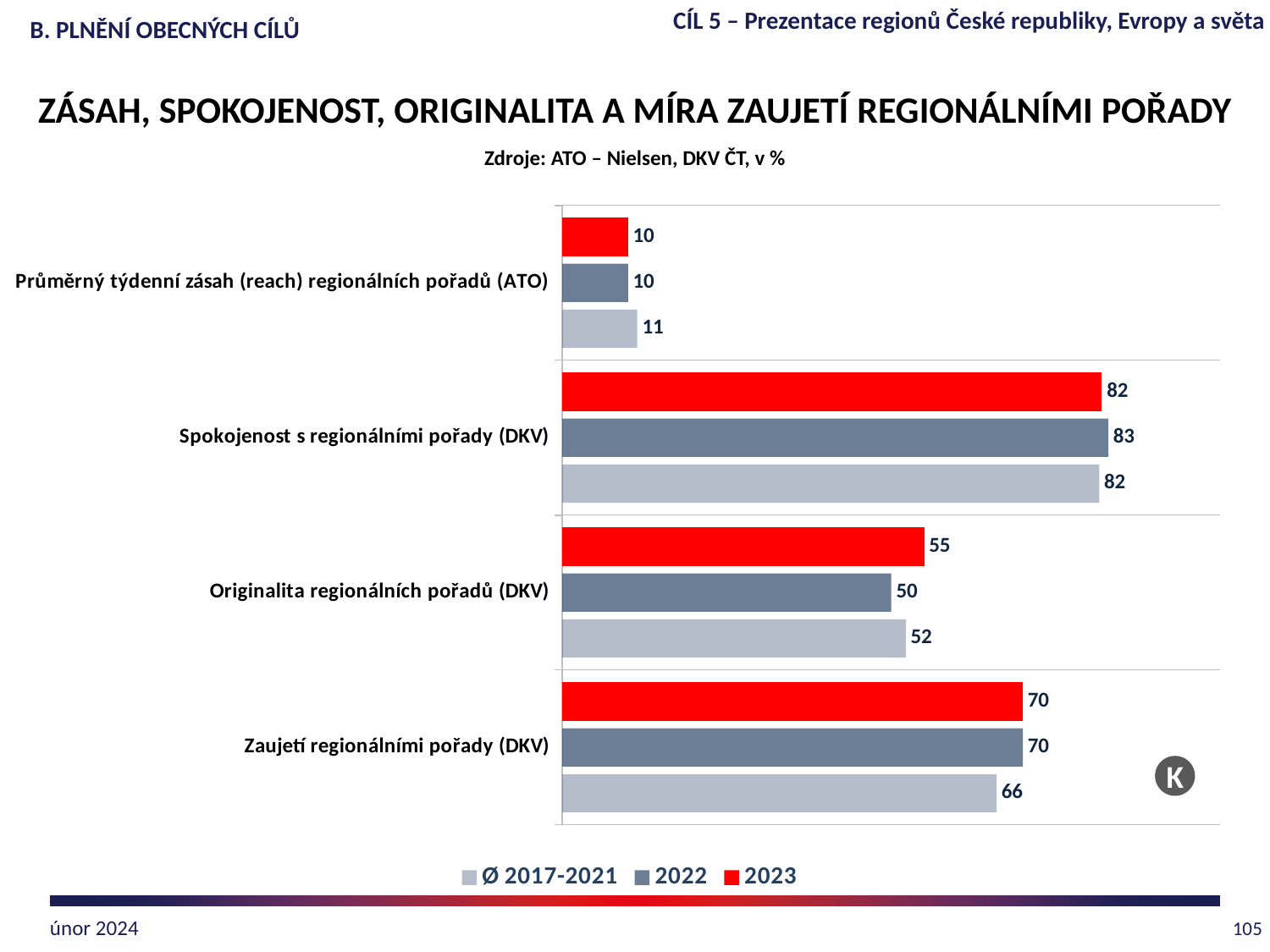
How many series does the legend list? 3 Which colour represents the 2023 series in the chart? Red What is the 2023 value for Spokojenost s regionálními pořady (DKV)? 82 What is the Ø 2017-2021 value for Zaujetí regionálními pořady (DKV)? 66 Which category has the highest 2023 value? Spokojenost s regionálními pořady (DKV) Which category has the lowest 2022 value? Průměrný týdenní zásah (reach) regionálních pořadů (ATO) How many categories are shown on the chart? 4 What kind of chart is shown on the slide? Bar chart What is the difference between the 2023 and 2022 values for Originalita regionálních pořadů (DKV)? 5 What is the Ø 2017-2021 value for Průměrný týdenní zásah (reach) regionálních pořadů (ATO)? 11 For Zaujetí regionálními pořady (DKV), which is larger: the 2023 value or the Ø 2017-2021 value? 2023 What is the 2022 value for Originalita regionálních pořadů (DKV)? 50